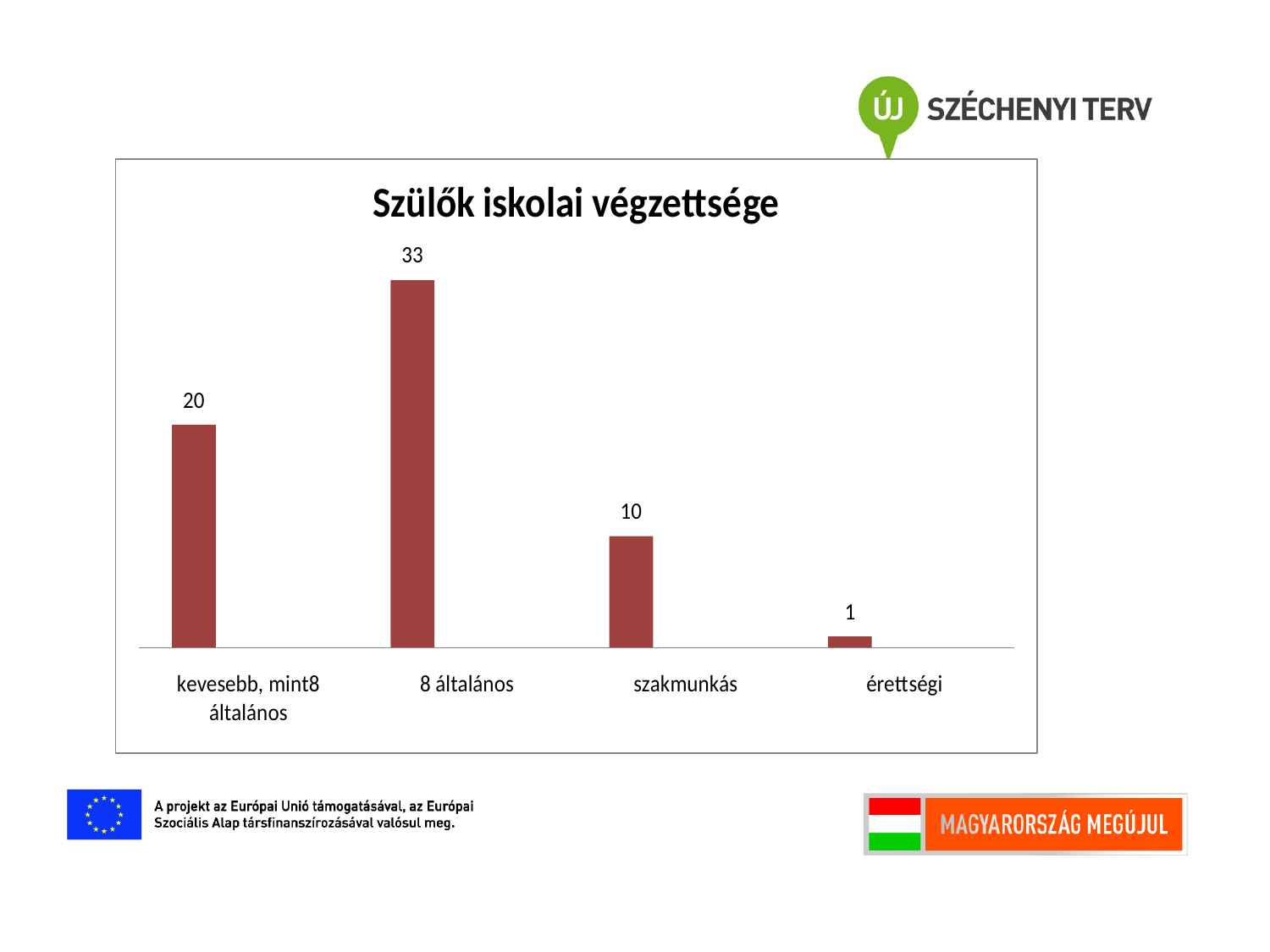
What is the difference between the values for "szakmunkás" and "érettségi"? 9 Which category has the lowest value? érettségi What is the value for "szakmunkás"? 10 What is the value for "érettségi"? 1 What kind of chart is shown on the slide? bar chart What is the title of the chart? Szülők iskolai végzettsége What is the value for "kevesebb, mint8 általános"? 20 How many categories are shown on the chart? 4 What is the difference between the values for "8 általános" and "kevesebb, mint8 általános"? 13 Which category has the highest value? 8 általános What is the value for "8 általános"? 33 Which is larger, the value for "kevesebb, mint8 általános" or the value for "szakmunkás"? kevesebb, mint8 általános